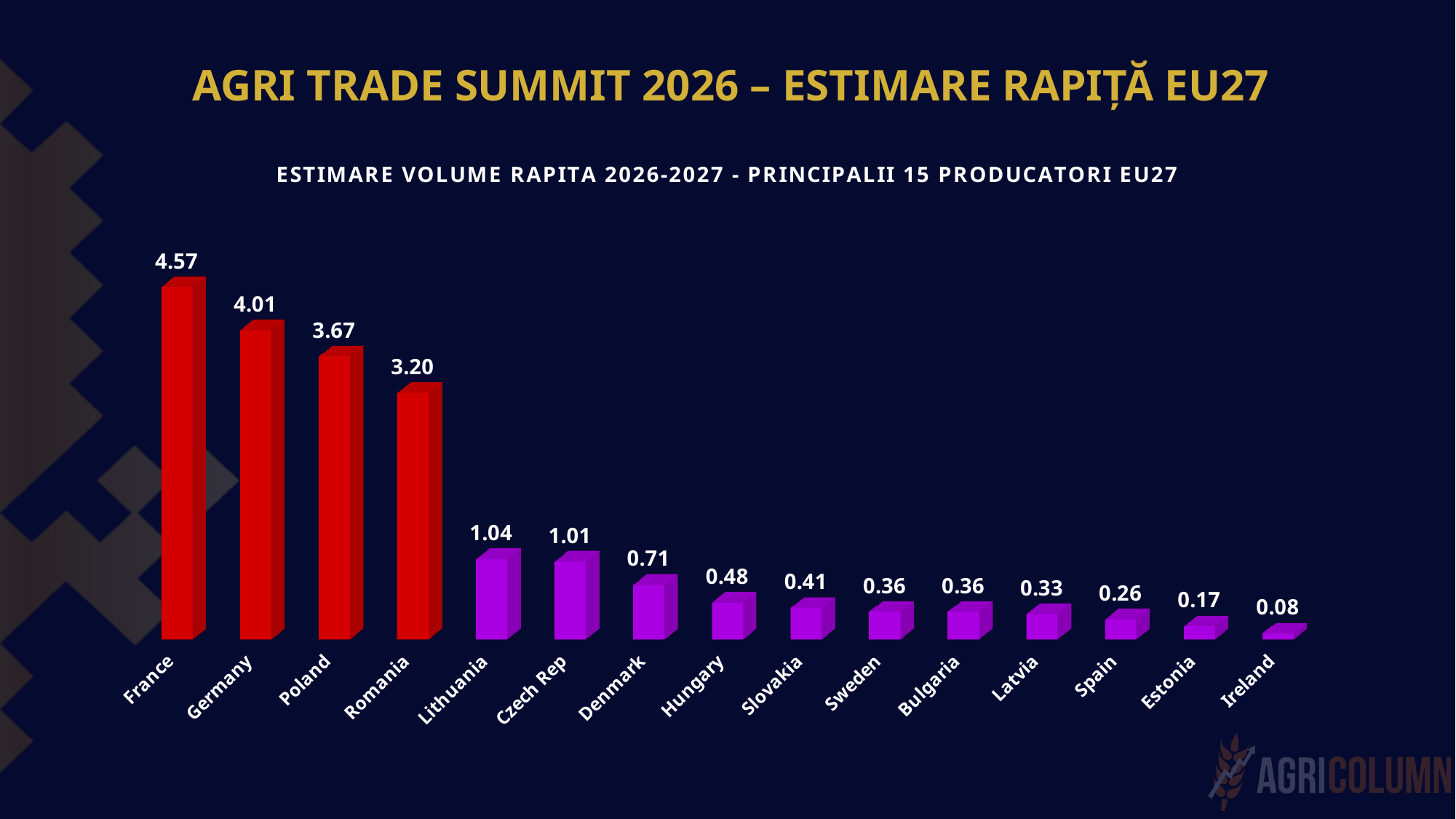
Do the values rise or fall from left to right along the x axis? Fall What is the title of the chart? ESTIMARE VOLUME RAPITA 2026-2027 - PRINCIPALII 15 PRODUCATORI EU27 What is the difference between the values for Lithuania and Czech Rep? 0.03 Which is larger, the value for Poland or the value for Romania? Poland What is the estimated rapeseed volume for France? 4.57 How many countries are shown on the chart? 15 What is the value shown for Denmark? 0.71 What is the difference between the values for France and Germany? 0.56 Which country has the lowest value on the chart? Ireland What is the value shown for Romania? 3.20 Which country has the highest value on the chart? France What kind of chart is shown on the slide? Bar chart